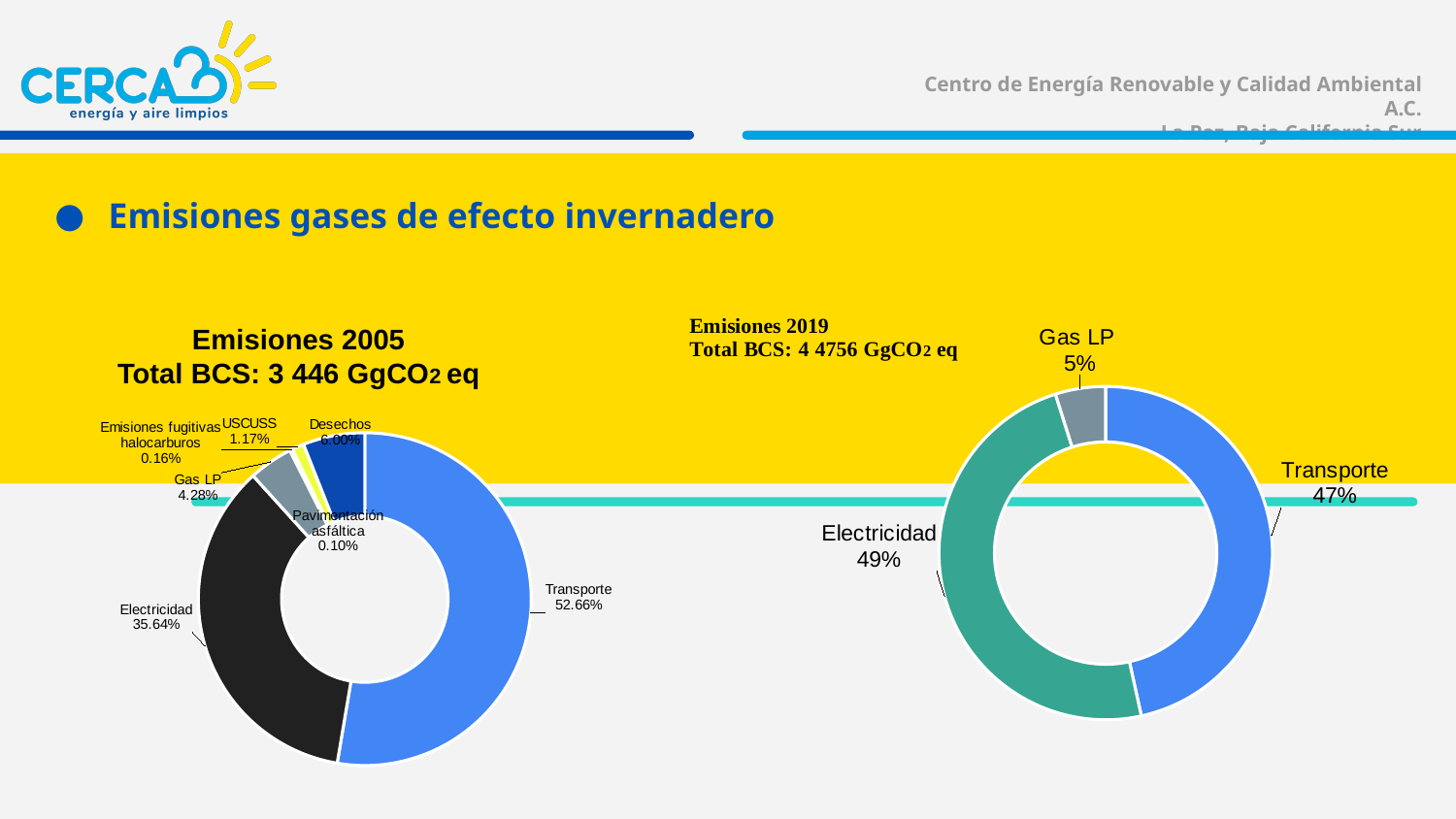
In the Emisiones 2005 chart, which category has the largest share? Transporte In the Emisiones 2005 chart, what share does Desechos have? 6.00% In the Emisiones 2019 chart, what share does Electricidad have? 49% In the Emisiones 2005 chart, what share does Transporte have? 52.66% In the Emisiones 2005 chart, what share does Electricidad have? 35.64% How many categories are shown in the Emisiones 2019 chart? 3 In the Emisiones 2005 chart, which category has the smallest share? Pavimentación asfáltica In the Emisiones 2005 chart, what is the difference between the Transporte and Electricidad shares? 17.02% How many categories are shown in the Emisiones 2005 chart? 7 What type of chart is the Emisiones 2019 chart? Doughnut chart In the Emisiones 2005 chart, what share does Gas LP have? 4.28% In the Emisiones 2019 chart, which category has the smallest share? Gas LP